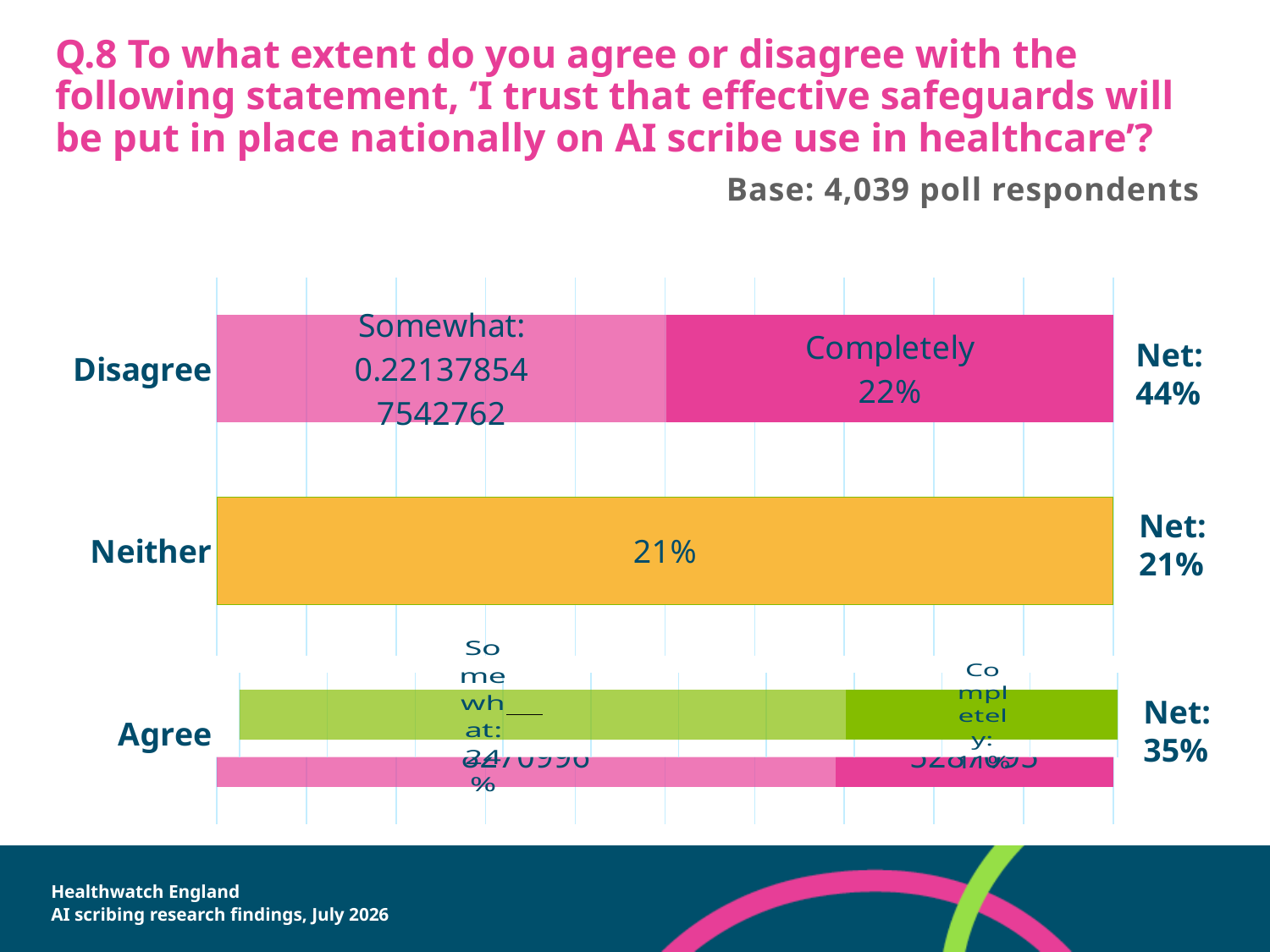
Which category has the lowest Net value? Neither What is the Net value shown for the Neither bar? 21% What is the difference between the Net value for Disagree and the Net value for Agree? 9 percentage points What kind of chart is shown on the slide? Bar chart What value is printed on the Neither bar? 21% What is the Net value shown for the Disagree bar? 44% Which is larger, the Net value for Disagree or the Net value for Agree? Disagree What is the Net value shown for the Agree bar? 35% How many poll respondents form the base for this chart? 4,039 How many response categories are shown on the chart? 3 What percentage is labelled for the 'Completely' segment of the Disagree bar? 22% Which category has the highest Net value? Disagree